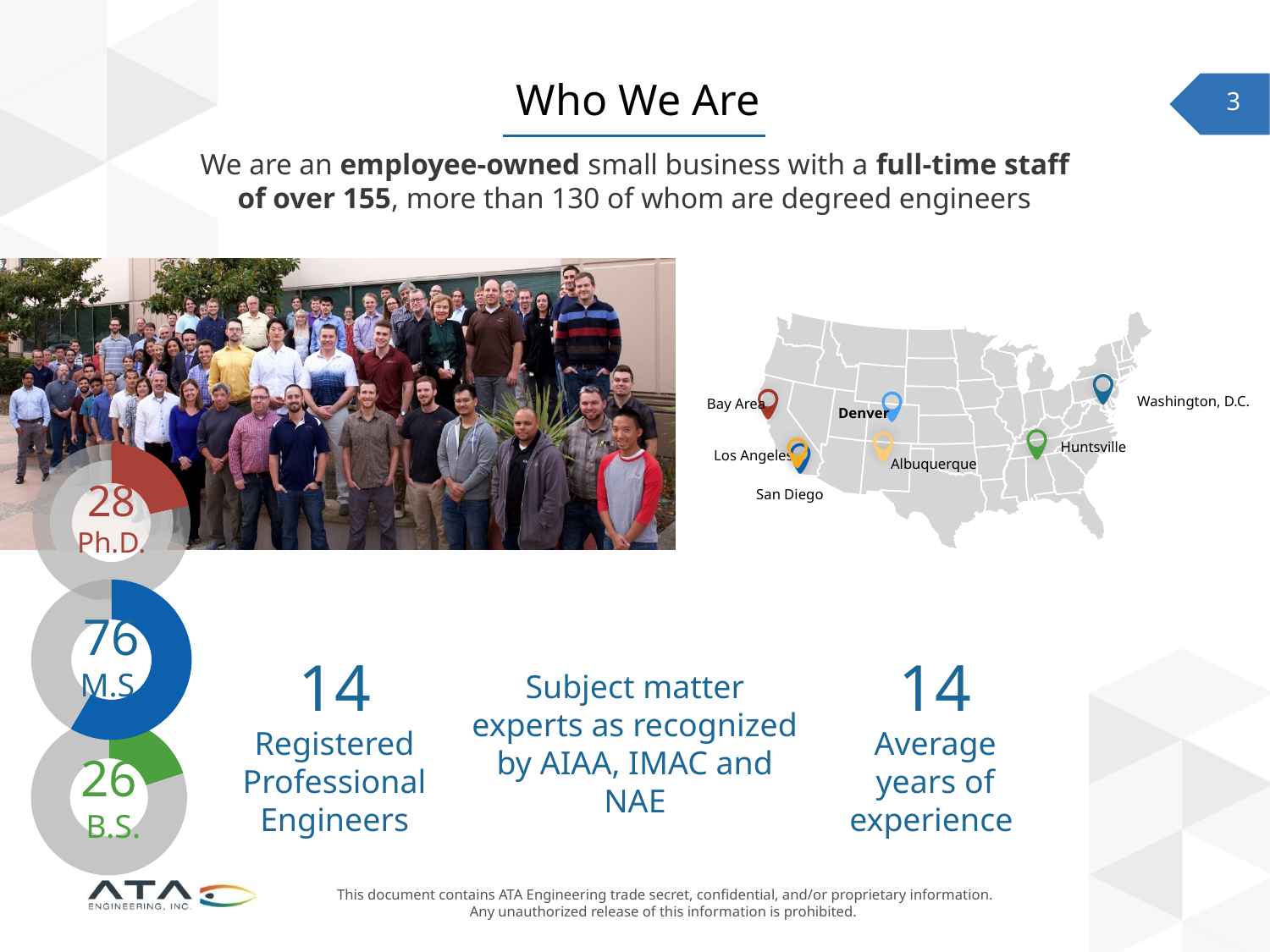
What kind of chart is used to show the Ph.D., M.S. and B.S. figures on the left of the slide? Donut chart Among the three degree donut charts (Ph.D., M.S., B.S.), which degree has the highest value? M.S. Among the three degree donut charts (Ph.D., M.S., B.S.), which degree has the lowest value? B.S. Which is larger in the donut charts, the M.S. value or the B.S. value? M.S. What value is shown in the M.S. donut chart on the left of the slide? 76 What is the difference between the M.S. value and the Ph.D. value shown in the donut charts? 48 What colour is the filled segment of the M.S. donut chart? Blue What value is shown in the B.S. donut chart on the left of the slide? 26 What colour is the filled segment of the B.S. donut chart? Green How many degree donut charts are shown on the left of the slide? 3 What value is shown in the Ph.D. donut chart on the left of the slide? 28 What is the difference between the Ph.D. value and the B.S. value shown in the donut charts? 2